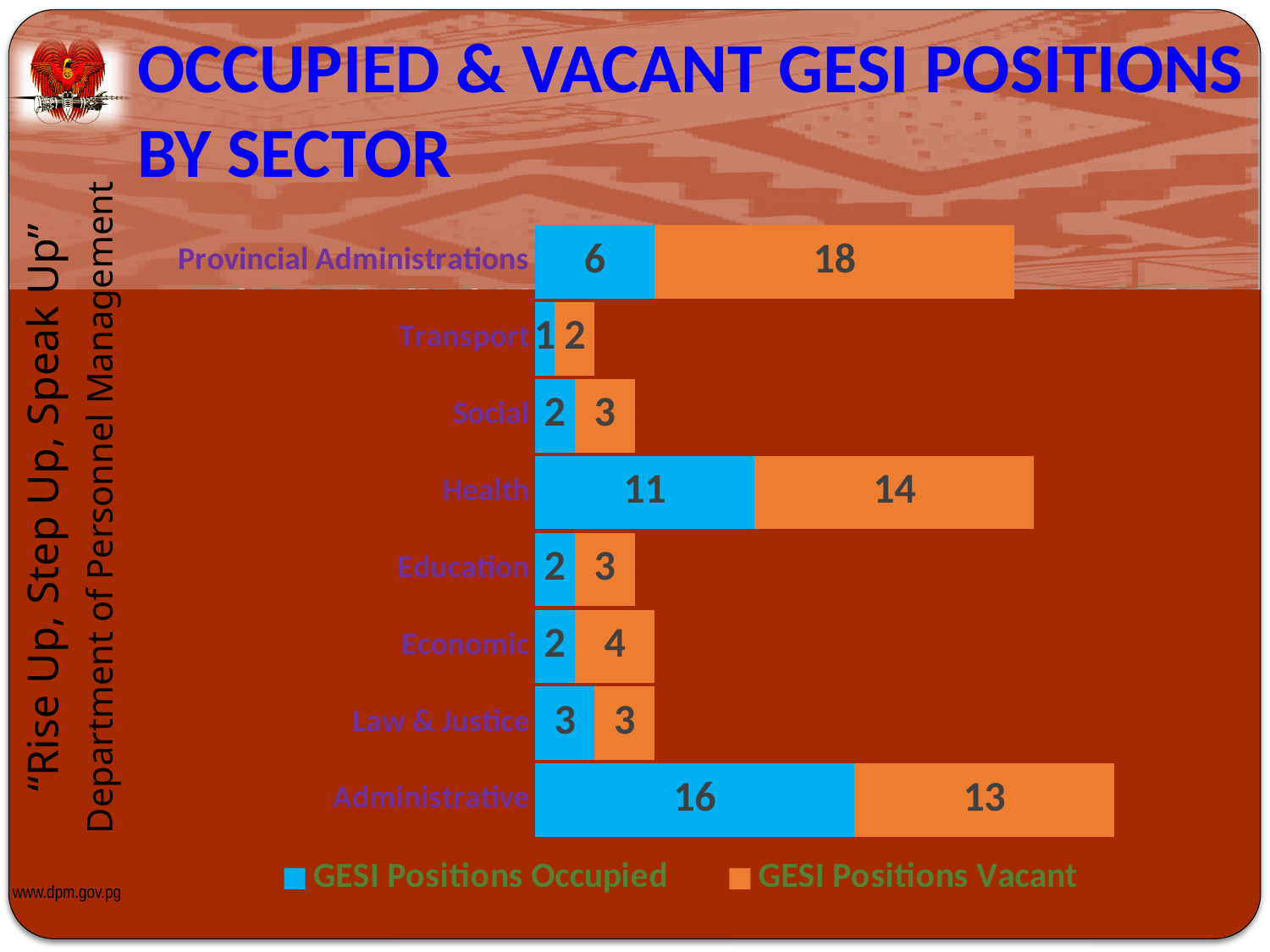
How many GESI positions are occupied in the Health sector? 11 How many sectors are shown in the chart? 8 Which sector has the lowest number of occupied GESI positions? Transport Which sector has the highest number of occupied GESI positions? Administrative What is the difference between vacant and occupied GESI positions in Provincial Administrations? 12 Which is larger for the Administrative sector: occupied or vacant GESI positions? Occupied How many series does the legend list? 2 What is the total number of GESI positions (occupied plus vacant) in the Health sector? 25 What is the total number of GESI positions (occupied plus vacant) in the Administrative sector? 29 How many GESI positions are vacant in Provincial Administrations? 18 What kind of chart is shown on the slide? Stacked bar chart Which colour represents GESI Positions Vacant in the chart? Orange